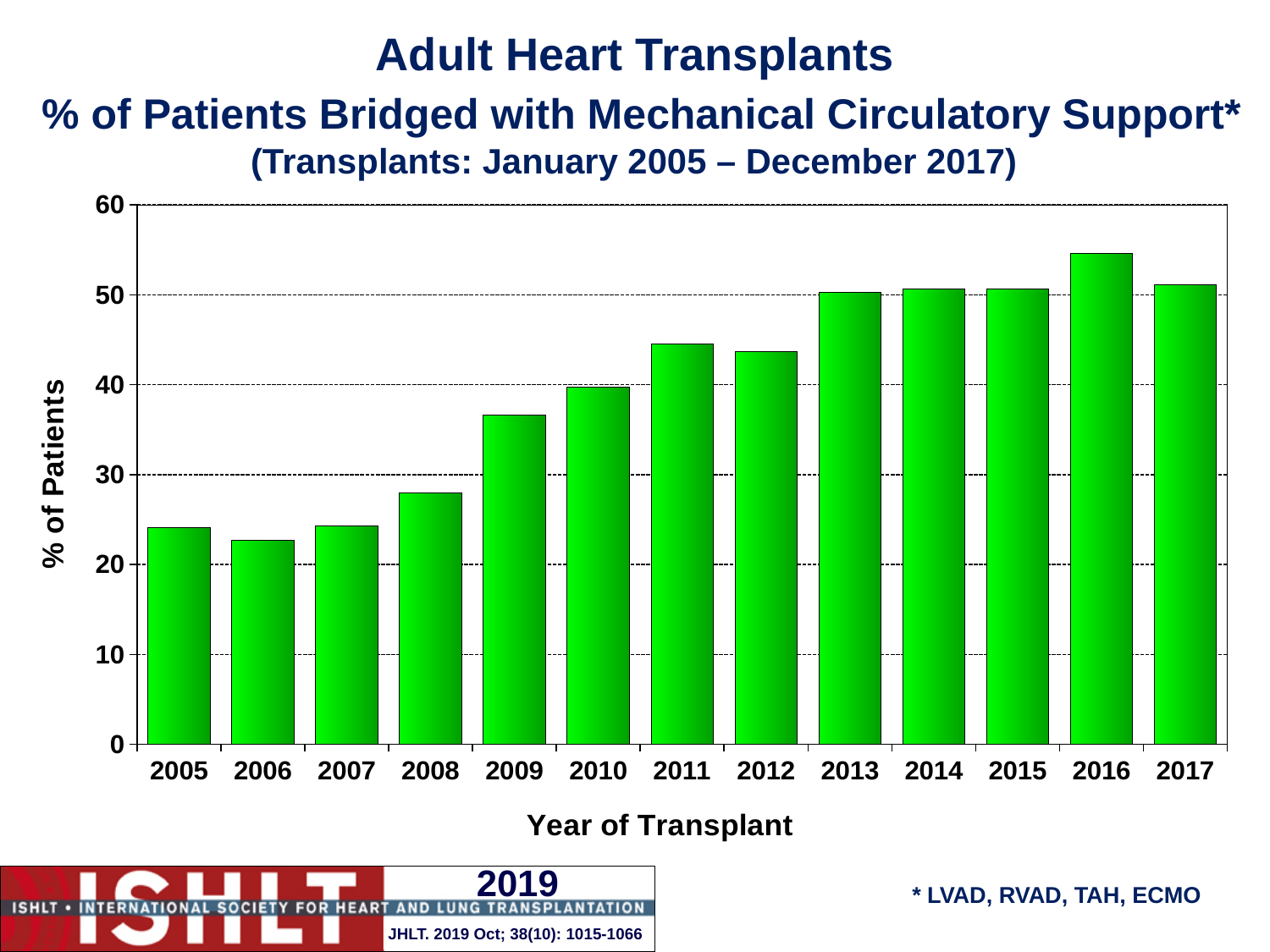
What is the label of the y axis? % of Patients Is the value for 2016 greater or less than 50? greater How many years are plotted along the x axis? 13 Is the value for 2005 greater or less than 30? less Which year has the larger value, 2016 or 2017? 2016 Is the value for 2009 greater or less than 30? greater What kind of chart is shown on the slide? bar chart Overall, do the values rise or fall from 2005 to 2017? rise Which year has the lowest % of patients bridged with mechanical circulatory support? 2006 Which year has the larger value, 2008 or 2009? 2009 Which year has the highest % of patients bridged with mechanical circulatory support? 2016